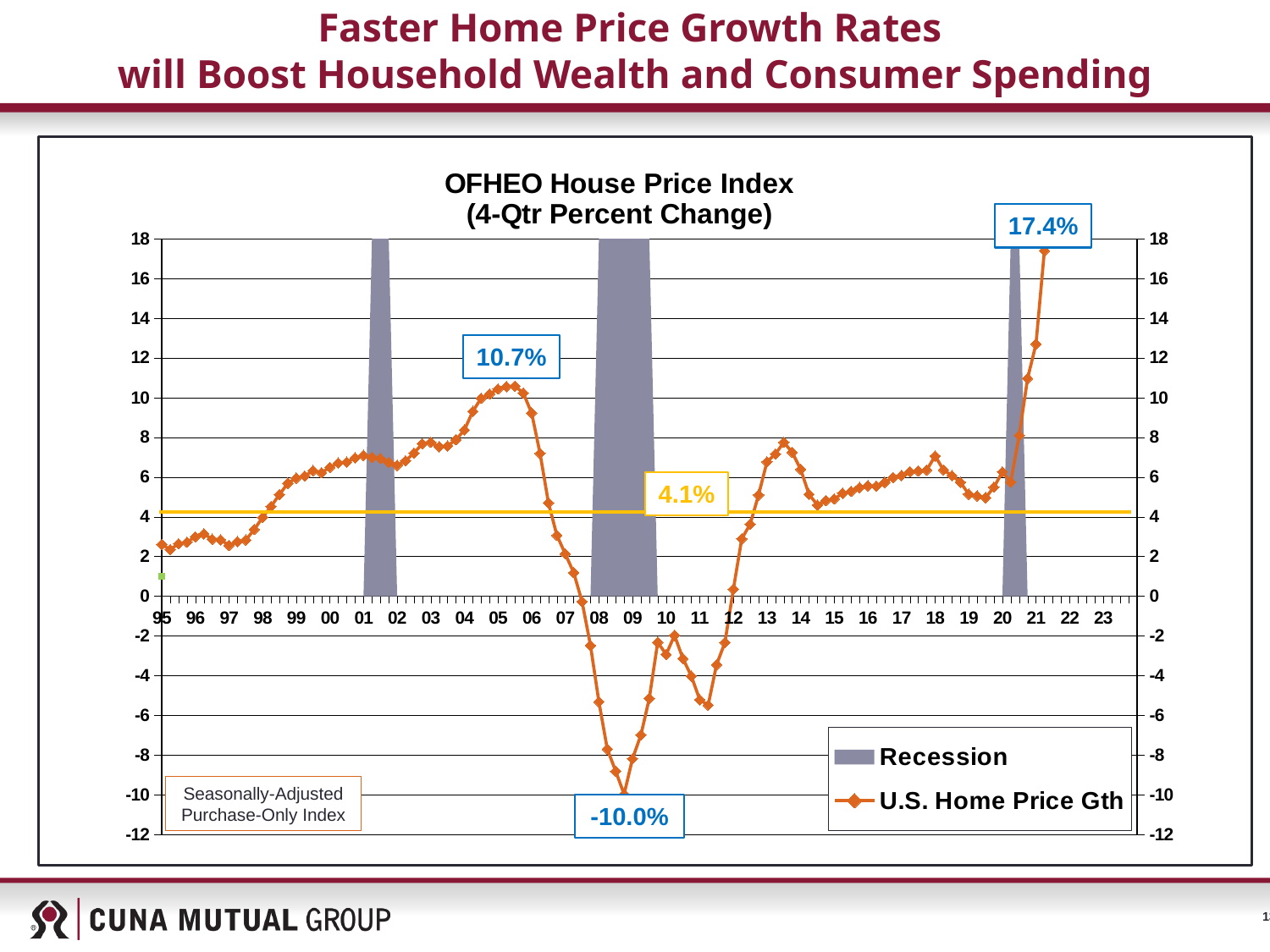
What is the difference between the labeled 2021 peak (17.4%) and the labeled 2005 peak (10.7%)? 6.7 percentage points What value is labeled on the horizontal yellow line across the chart? 4.1% What is the labeled peak value of U.S. Home Price Gth reached around 2005? 10.7% What is the labeled lowest value of U.S. Home Price Gth, reached around 2009? -10.0% Between 2005 and 2009, do the values of U.S. Home Price Gth rise or fall? fall Is the value of U.S. Home Price Gth around 2011 greater or less than 0? less What is the labeled highest value of U.S. Home Price Gth, reached around 2021? 17.4% What kind of chart is shown on the slide? line chart What is the title of the chart? OFHEO House Price Index (4-Qtr Percent Change) Is the value of U.S. Home Price Gth at the start of 1995 greater or less than 4? less Which is larger, the labeled peak around 2005 or the labeled peak around 2021? the peak around 2021 (17.4%) How many entries does the legend list? 2